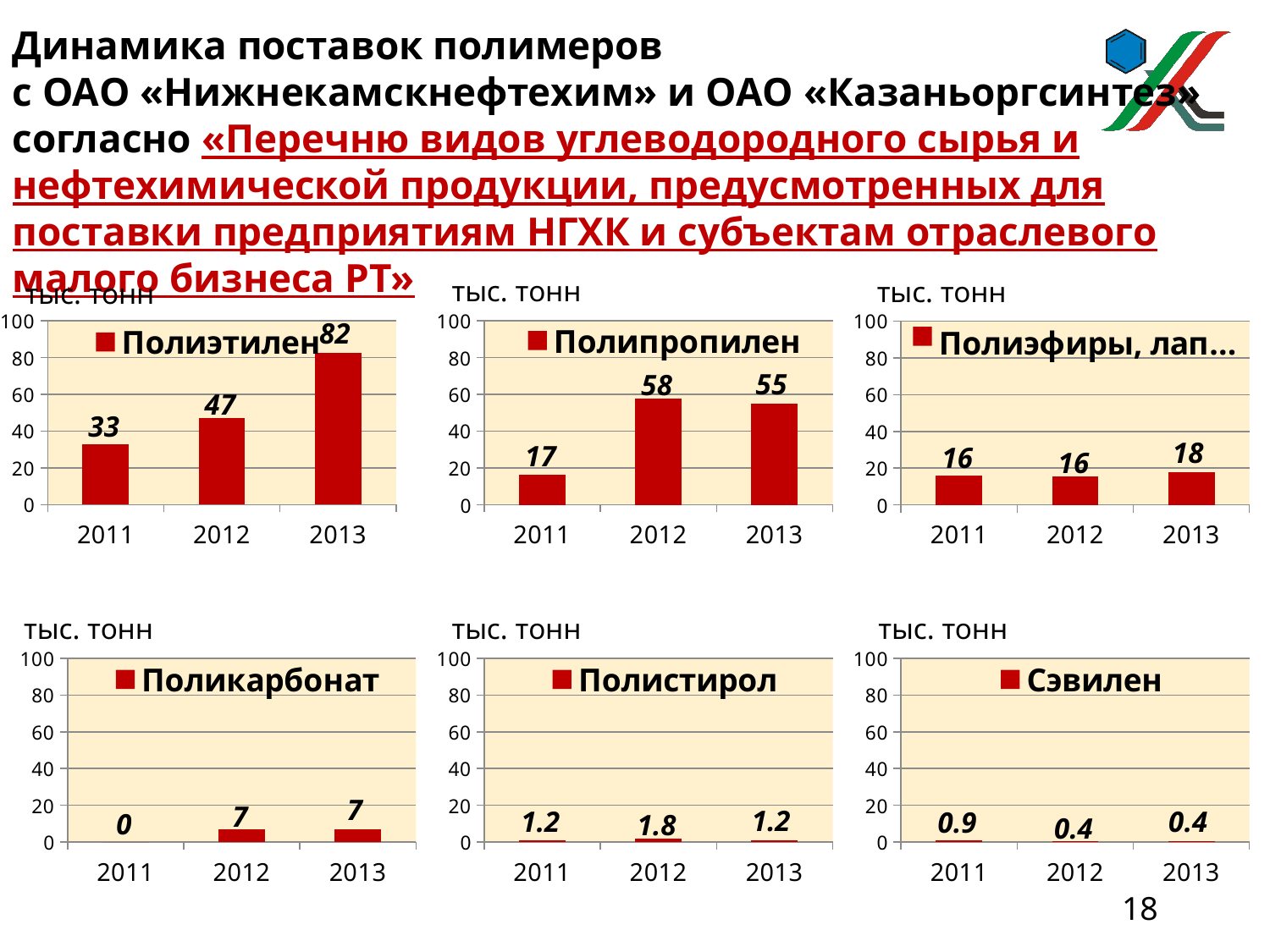
What unit is shown above each chart on the slide? тыс. тонн In the Полипропилен chart, which year has the highest value? 2012 In the Полистирол chart, what is the value for 2012? 1.8 What kind of chart is the Поликарбонат chart? bar chart In the Сэвилен chart, which year has the highest value? 2011 In the Полиэтилен chart, what is the value for 2013? 82 How many bar charts are shown on the slide? 6 In the Поликарбонат chart, which year has the lowest value? 2011 In the Полиэтилен chart, what is the difference between the 2013 and 2011 values? 49 In the Полиэтилен chart, do the values rise or fall from 2011 to 2013? rise In the Полипропилен chart, what is the value for 2011? 17 In the Полипропилен chart, is the value for 2012 greater or less than 40? greater